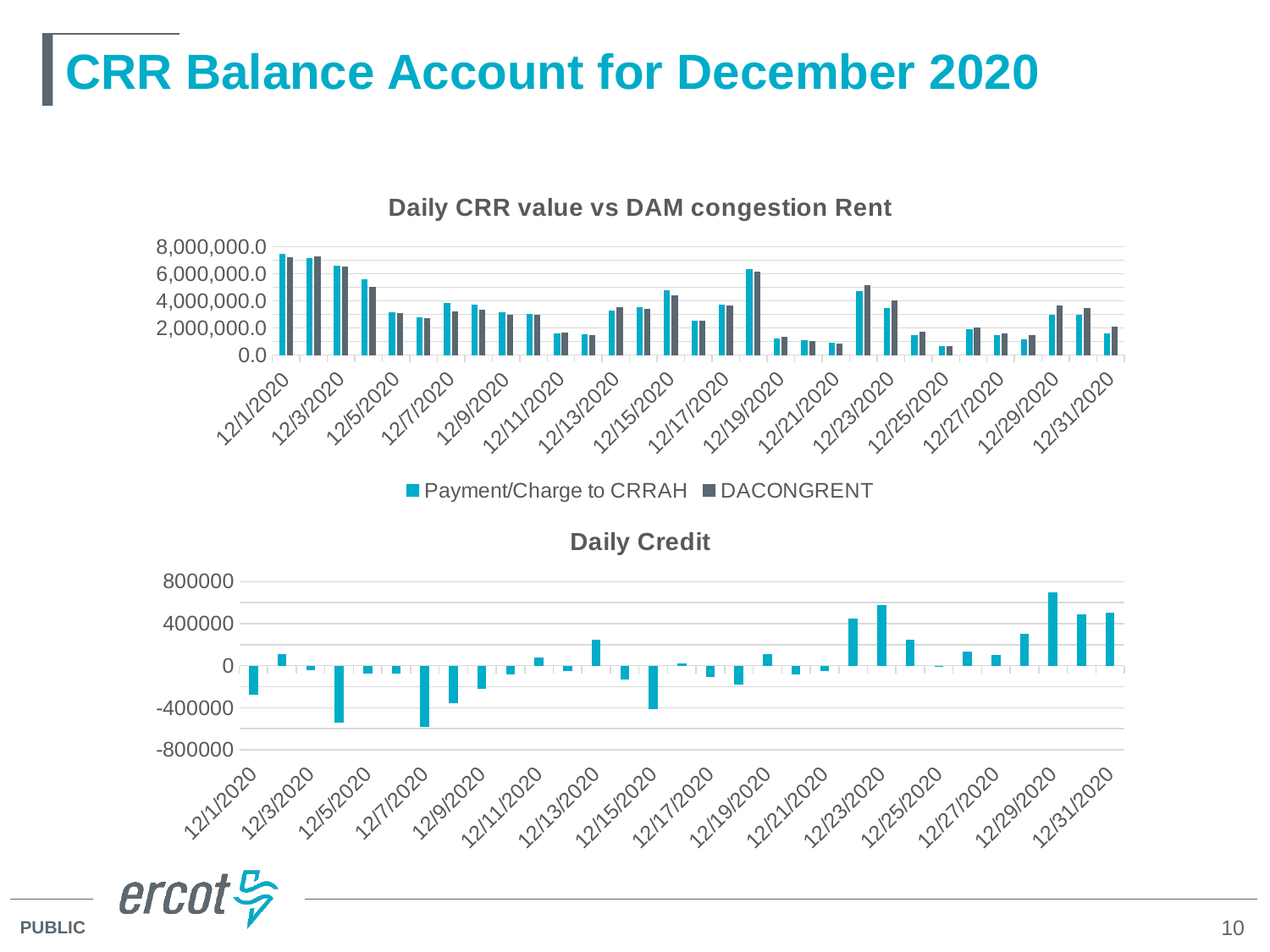
In the 'Daily CRR value vs DAM congestion Rent' chart, is the Payment/Charge to CRRAH value for 12/1/2020 greater or less than 6,000,000.0? greater How many series does the legend of the 'Daily CRR value vs DAM congestion Rent' chart list? 2 What type of chart is the 'Daily CRR value vs DAM congestion Rent' chart? Bar chart How many days are plotted in the 'Daily Credit' chart? 31 In the 'Daily Credit' chart, is the value for 12/7/2020 greater or less than -400000? less In the 'Daily CRR value vs DAM congestion Rent' chart, which is larger: the Payment/Charge to CRRAH value for 12/1/2020 or for 12/25/2020? 12/1/2020 In the 'Daily Credit' chart, which is larger: the value for 12/29/2020 or for 12/1/2020? 12/29/2020 In the 'Daily Credit' chart, is the value for 12/29/2020 greater or less than 400000? greater In the 'Daily CRR value vs DAM congestion Rent' chart, do the values generally rise or fall from 12/1/2020 to 12/31/2020? fall What is the title of the top chart on the slide? Daily CRR value vs DAM congestion Rent In the 'Daily Credit' chart, which date has the highest value? 12/29/2020